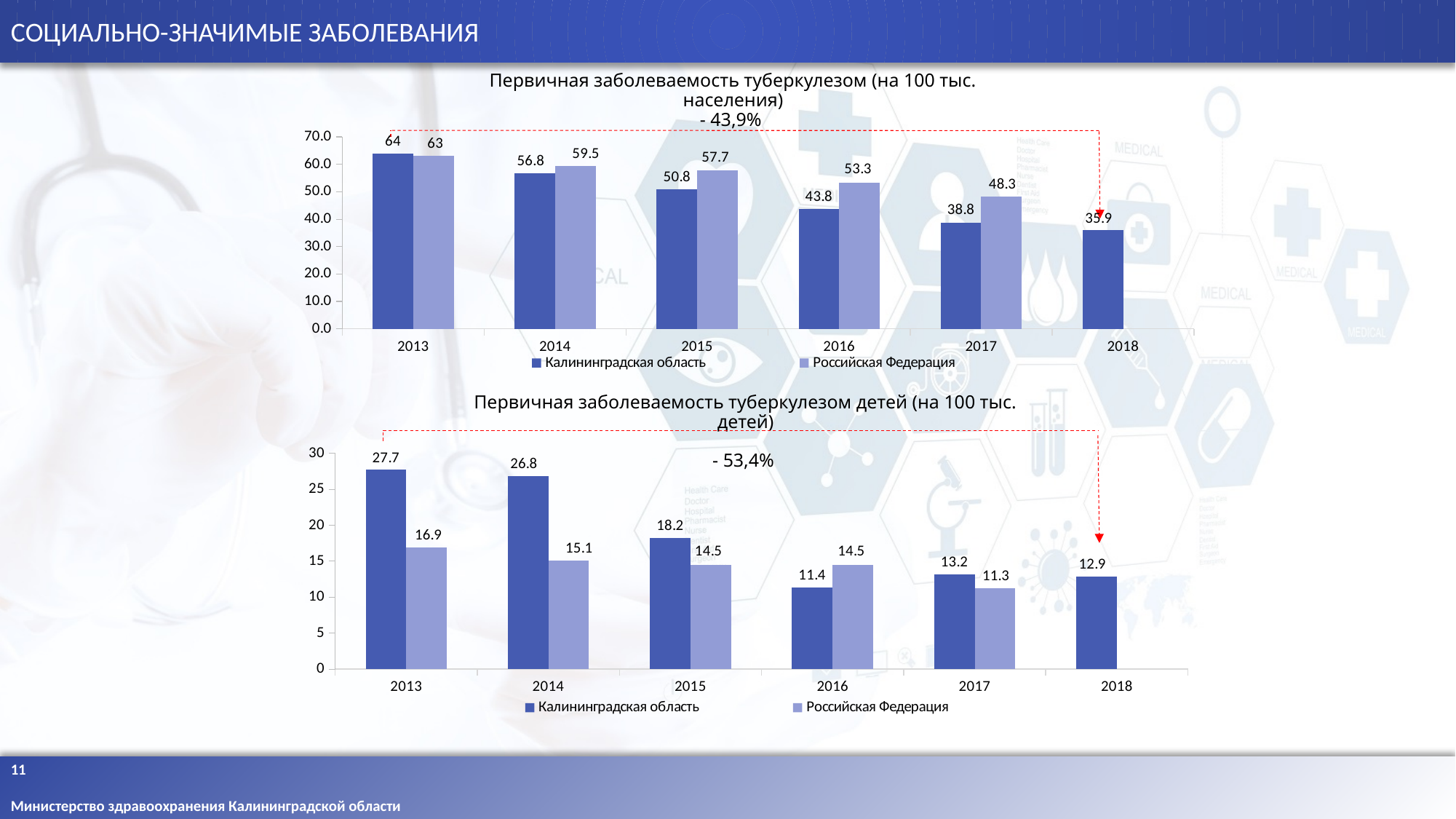
In the top chart (Первичная заболеваемость туберкулезом), how many series does the legend list? 2 In the bottom chart (Первичная заболеваемость туберкулезом детей), how many years are shown on the x axis? 6 In the top chart (Первичная заболеваемость туберкулезом), which year has the highest value for Калининградская область? 2013 In the top chart (Первичная заболеваемость туберкулезом), what is the difference between Российская Федерация and Калининградская область in 2017? 9.5 In the bottom chart (Первичная заболеваемость туберкулезом детей), which is larger in 2014: Калининградская область or Российская Федерация? Калининградская область In the bottom chart (Первичная заболеваемость туберкулезом детей), what is the difference between Калининградская область and Российская Федерация in 2013? 10.8 What kind of chart is the bottom chart (Первичная заболеваемость туберкулезом детей)? bar chart In the top chart (Первичная заболеваемость туберкулезом), what is the value for Калининградская область in 2018? 35.9 In the bottom chart (Первичная заболеваемость туберкулезом детей), which year has the lowest value for Российская Федерация? 2017 In the top chart (Первичная заболеваемость туберкулезом), what is the value for Российская Федерация in 2015? 57.7 In the bottom chart (Первичная заболеваемость туберкулезом детей), what is the value for Калининградская область in 2016? 11.4 In the top chart (Первичная заболеваемость туберкулезом), does the value for Калининградская область rise or fall from 2013 to 2018? fall